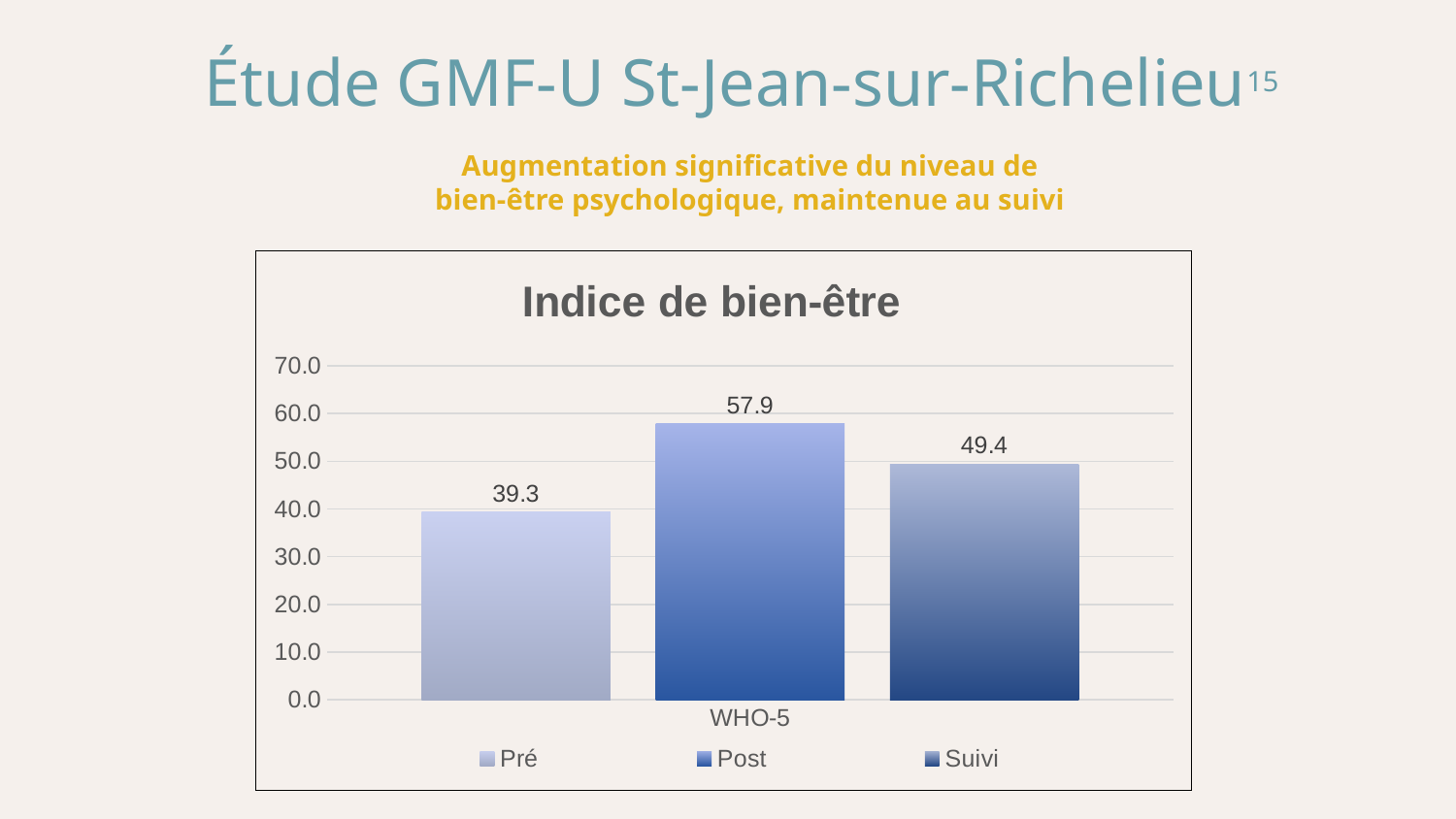
What is the value for Post in the Indice de bien-être chart? 57.9 What is the difference between the Post and Suivi values? 8.5 How many series does the legend list? 3 What is the difference between the Post and Pré values? 18.6 What is the value for Suivi in the Indice de bien-être chart? 49.4 Which series has the highest value in the Indice de bien-être chart? Post Which is larger, the value for Suivi or the value for Pré? Suivi What is the title of the chart? Indice de bien-être What is the value for Pré in the Indice de bien-être chart? 39.3 Which series has the lowest value in the Indice de bien-être chart? Pré What kind of chart is shown on the slide? Bar chart Is the value for Post greater or less than 50.0? greater